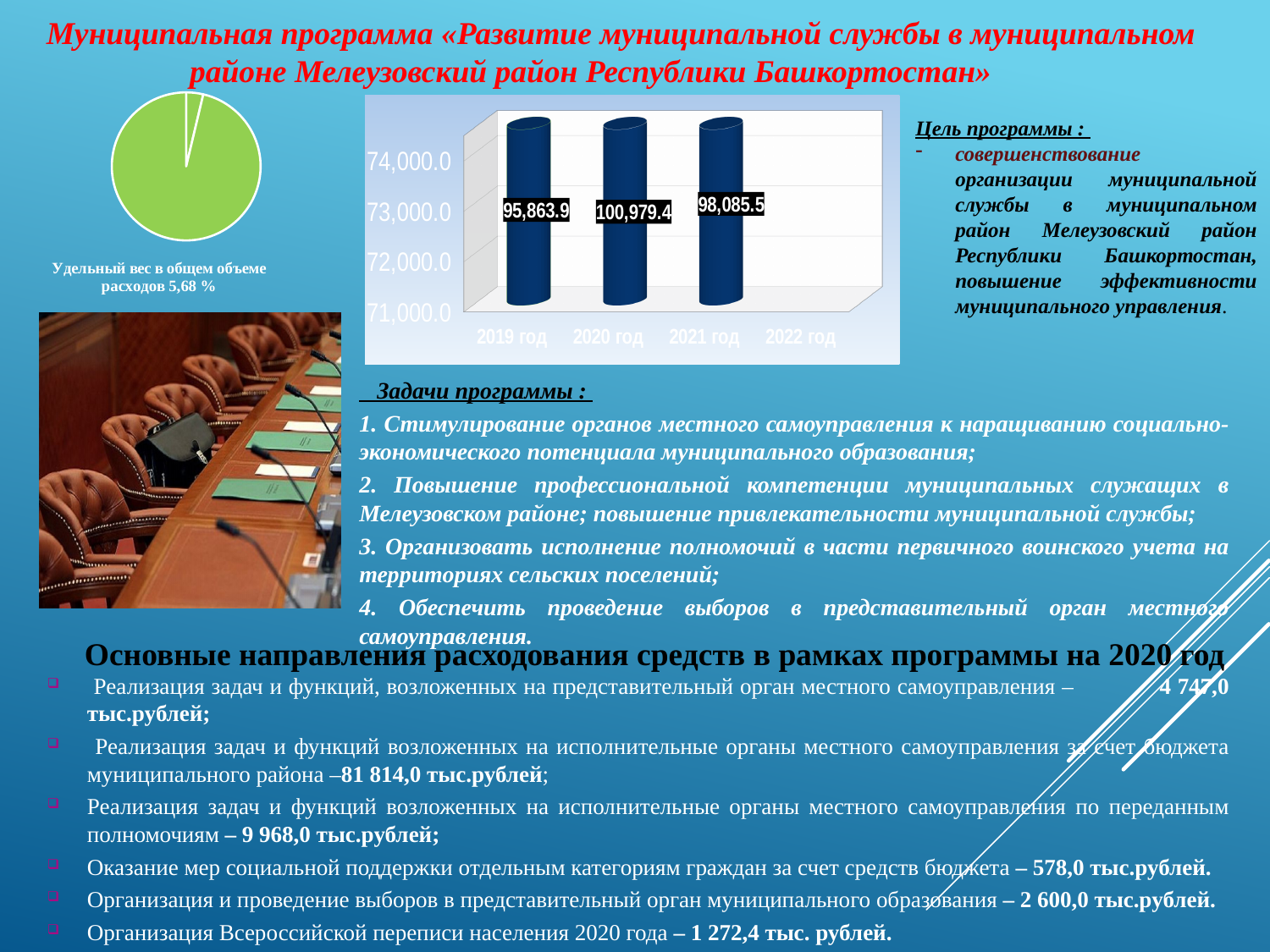
What kind of chart is the chart at the top centre of the slide? bar chart In the bar chart, what is the difference between the values for 2020 год and 2021 год? 2,893.9 In the bar chart, which is larger: the value for 2021 год or the value for 2019 год? 2021 год In the bar chart, which year has the lowest value among the plotted bars? 2019 год In the bar chart, what is the value for 2021 год? 98,085.5 In the pie chart at the top left, what share of total expenditure does the small slice represent, according to its caption? 5,68 % In the bar chart, what is the difference between the values for 2020 год and 2019 год? 5,115.5 What kind of chart is the chart at the top left of the slide? pie chart In the bar chart, which year has the highest value? 2020 год In the bar chart, how many bars are plotted with values? 3 In the bar chart, what is the value for 2020 год? 100,979.4 In the bar chart, what is the value for 2019 год? 95,863.9